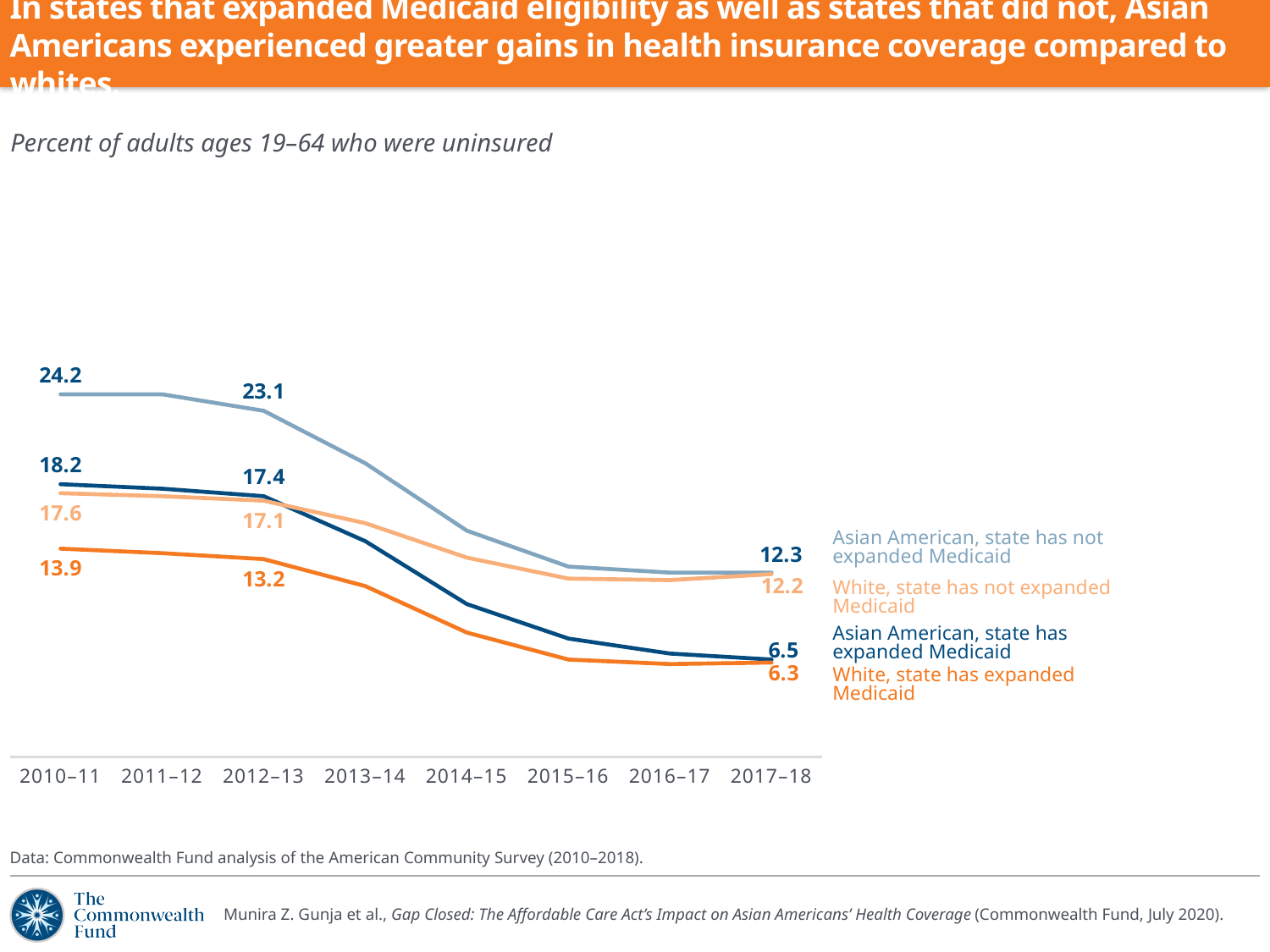
What was the uninsured rate for whites in states that had not expanded Medicaid in 2017–18? 12.2 What was the uninsured rate for Asian Americans in states that had not expanded Medicaid in 2010–11? 24.2 Which series had the highest uninsured rate in 2010–11? Asian American, state has not expanded Medicaid What kind of chart is shown on the slide? Line chart Do the uninsured rates rise or fall from 2010–11 to 2017–18? Fall By how many percentage points did the uninsured rate for Asian Americans in states that had not expanded Medicaid fall from 2010–11 to 2017–18? 11.9 How many series does the legend list? 4 How many time periods are shown on the x axis? 8 What was the uninsured rate for whites in states that had expanded Medicaid in 2017–18? 6.3 In 2010–11, which was larger: the uninsured rate for Asian Americans in expansion states or for whites in non-expansion states? Asian Americans in expansion states Which series had the lowest uninsured rate in 2012–13? White, state has expanded Medicaid What was the uninsured rate for Asian Americans in states that had expanded Medicaid in 2012–13? 17.4